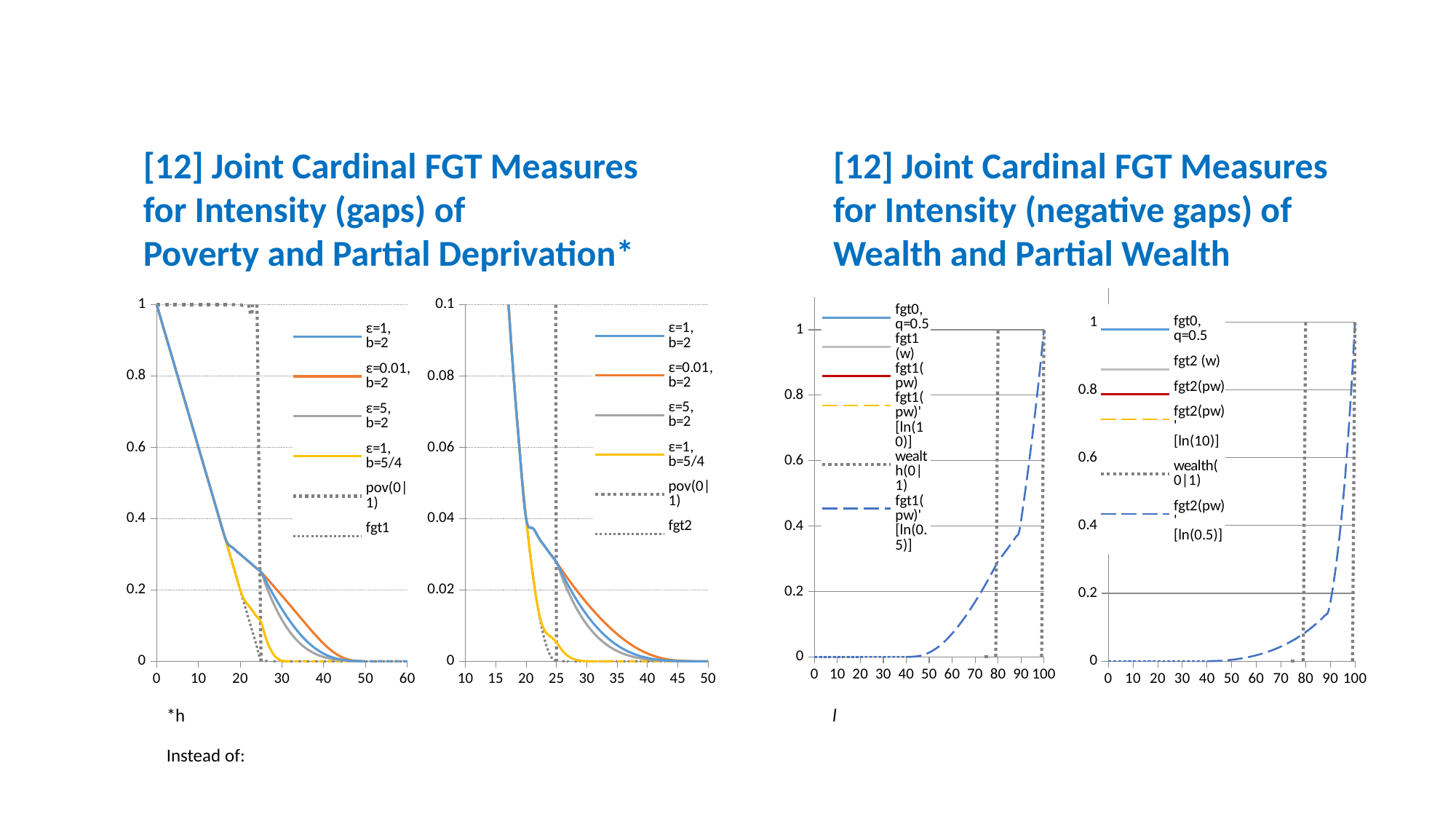
What is the maximum value shown on the y axis of the second chart from the left? 0.1 How many series does the legend of the leftmost chart list? 6 In the third chart from the left, is the value of the dashed fgt1(pw)' [ln(0.5)] series at x=80 greater or less than 0.2? greater What kind of chart is the leftmost chart on the slide? line chart What kind of chart is the rightmost chart on the slide? line chart How many series does the legend of the rightmost chart list? 6 Which legend entry in the second chart from the left differs from the leftmost chart's legend, replacing fgt1? fgt2 In the leftmost chart, is the value of the ε=1, b=2 series at x=40 greater or less than 0.2? less In the leftmost chart, is the value of the ε=1, b=2 series at x=10 greater or less than 0.4? greater In the third chart from the left, does the dashed fgt1(pw)' [ln(0.5)] series rise or fall as the x axis increases from 40 to 100? rise In the leftmost chart, do the values of the ε=1, b=2 series rise or fall as the x axis increases? fall